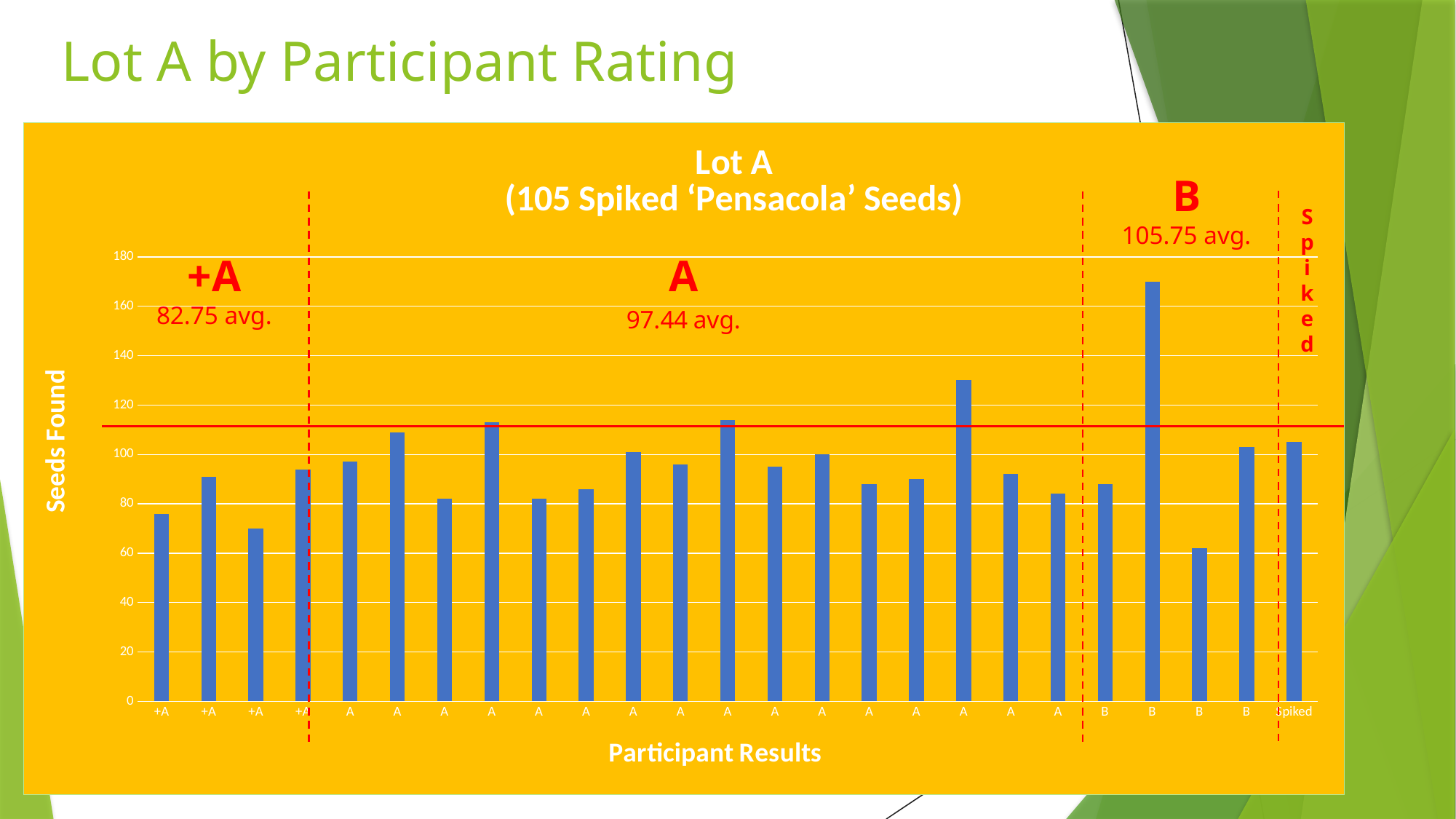
How many bars are labelled +A on the x axis? 4 What is the title of the y axis? Seeds Found Is the value of the third +A bar greater or less than 80? less What kind of chart is shown on the slide? bar chart What is the average shown for the A group? 97.44 avg. What is the average shown for the +A group? 82.75 avg. What is the average shown for the B group? 105.75 avg. Is the value of the tallest bar (the second B bar) greater or less than 160? greater How many bars are plotted in the chart? 25 Which group has the highest printed average: +A, A or B? B What is the difference between the B group average and the +A group average? 23 How many bars are labelled B on the x axis? 4